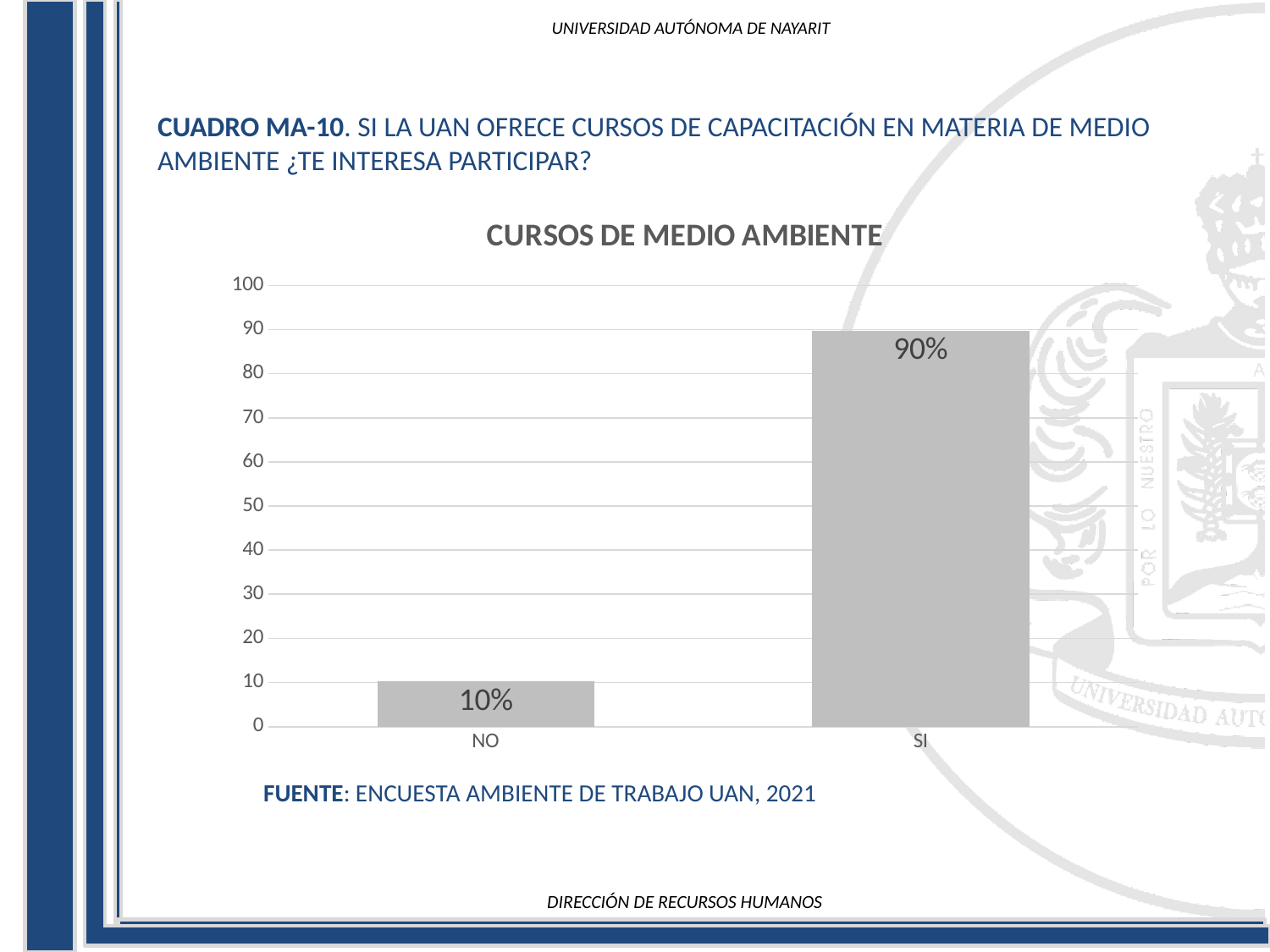
What is the value for NO? 10% What is the difference between the values for SI and NO? 80% Is the value for NO greater or less than 20? less Is the value for SI greater or less than 50? greater What is the maximum value shown on the y axis? 100 What kind of chart is shown on the slide? bar chart What is the title of the chart? CURSOS DE MEDIO AMBIENTE Which category has the highest value? SI How many categories are shown on the x axis? 2 Which category has the lowest value? NO Which is larger, the value for NO or the value for SI? SI What is the value for SI? 90%